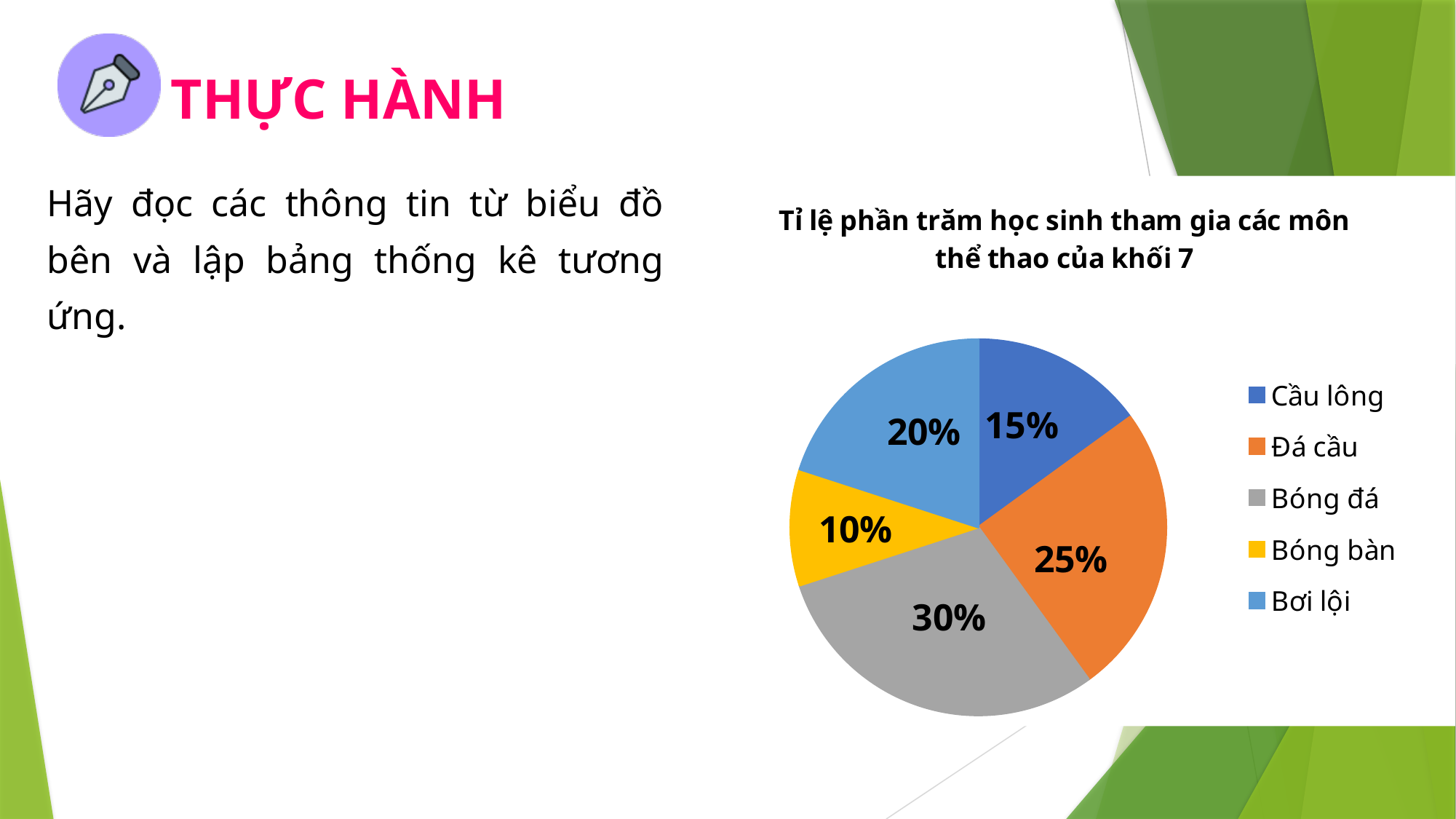
What colour is the slice for Bóng bàn? Yellow What is the title of the chart? Tỉ lệ phần trăm học sinh tham gia các môn thể thao của khối 7 Which sport has the smallest share of students? Bóng bàn What kind of chart is shown on the slide? Pie chart Which sport has the largest share of students? Bóng đá Which has a larger share, Bơi lội or Đá cầu? Đá cầu What percentage of students participate in Cầu lông? 15% What is the difference between the shares for Đá cầu and Cầu lông? 10% What percentage of students participate in Bóng đá? 30% What percentage of students participate in Bơi lội? 20% How many sports are shown in the pie chart? 5 What percentage of students participate in Bóng bàn? 10%